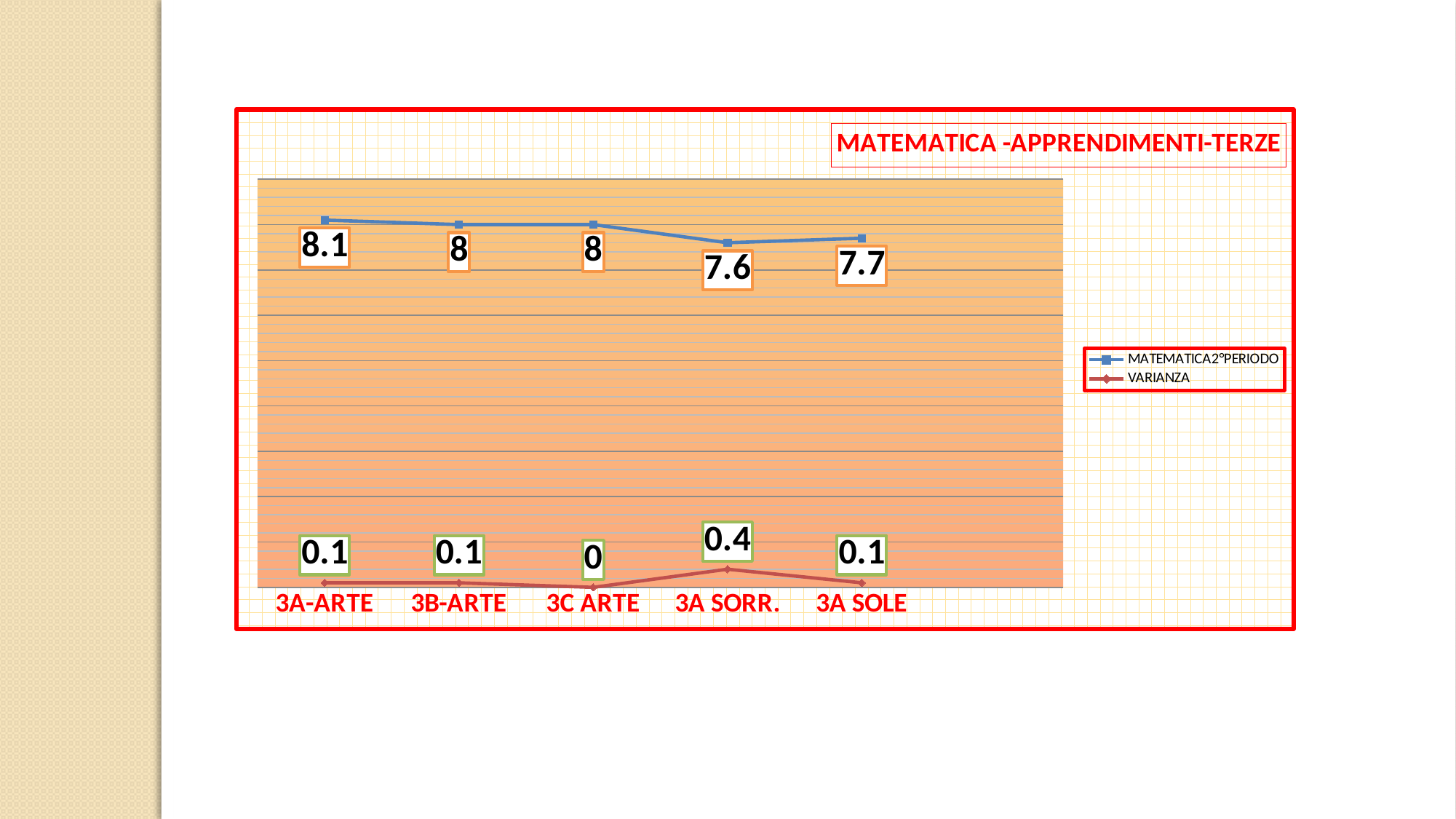
How many categories are shown on the x axis? 5 Which category has the lowest VARIANZA value? 3C ARTE Which category has the highest MATEMATICA 2°PERIODO value? 3A-ARTE Which category has the lowest MATEMATICA 2°PERIODO value? 3A SORR. What kind of chart is shown? Line chart Which is larger, the MATEMATICA 2°PERIODO value for 3A SOLE or for 3A SORR.? 3A SOLE What is the MATEMATICA 2°PERIODO value for 3A SOLE? 7.7 What is the title of the chart? MATEMATICA -APPRENDIMENTI-TERZE What is the VARIANZA value for 3A SORR.? 0.4 What is the MATEMATICA 2°PERIODO value for 3A-ARTE? 8.1 How many series does the legend list? 2 What is the difference between the MATEMATICA 2°PERIODO values for 3A-ARTE and 3A SORR.? 0.5